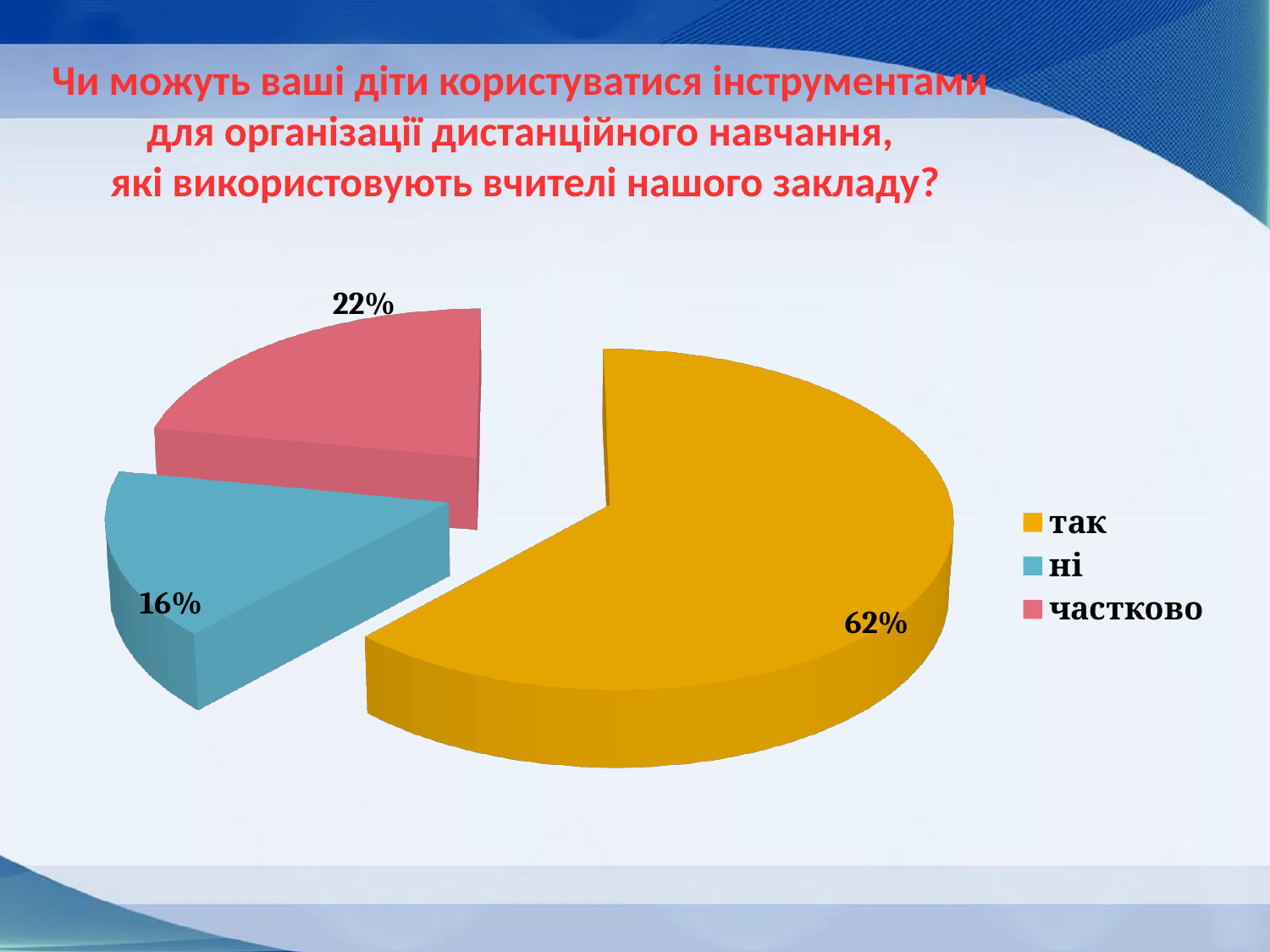
What is the difference in percentage points between the "частково" and "ні" slices? 6 How many entries does the legend list? 3 What is the difference in percentage points between the "так" and "частково" slices? 40 Which is larger, the "ні" slice or the "частково" slice? частково How many slices does the pie chart have? 3 What colour is the "так" slice? yellow/orange What percentage is shown for the "ні" slice? 16% What percentage is shown for the "так" slice? 62% What percentage is shown for the "частково" slice? 22% Which category has the largest share of the pie? так What kind of chart is shown on the slide? pie chart Which category has the smallest share of the pie? ні